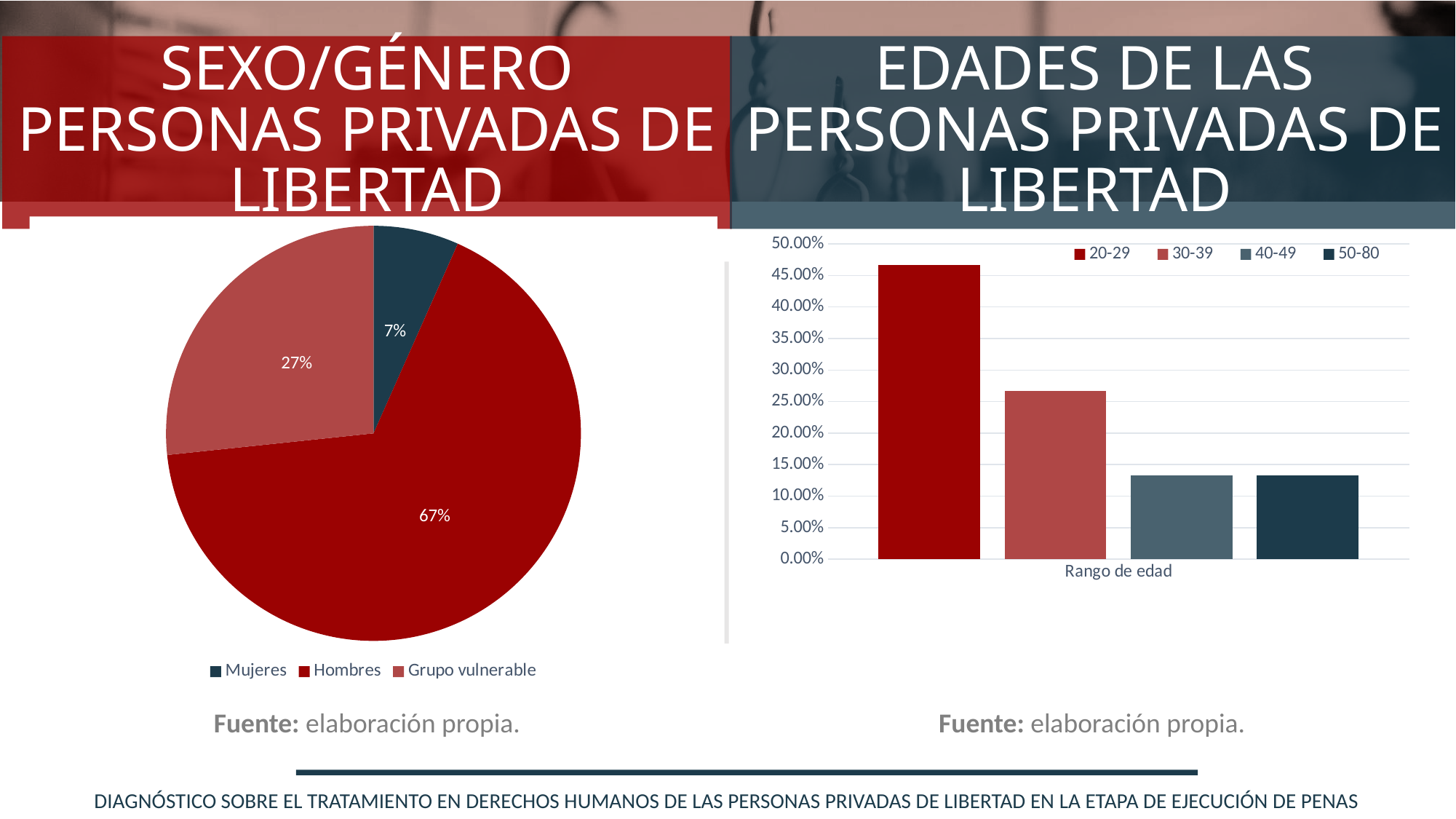
In the pie chart on the left, what percentage is shown for Grupo vulnerable? 27% What kind of chart is the chart on the right (Edades de las personas privadas de libertad)? bar chart In the pie chart on the left, what percentage is shown for Hombres? 67% In the bar chart on the right, is the value for 20-29 greater or less than 45.00%? greater In the pie chart on the left, which category has the smallest slice? Mujeres How many slices does the pie chart on the left have? 3 In the pie chart on the left, what percentage is shown for Mujeres? 7% In the bar chart on the right, which age range has the highest value? 20-29 In the pie chart on the left, what is the difference in percentage points between Hombres and Grupo vulnerable? 40 percentage points In the bar chart on the right, is the value for 40-49 greater or less than 15.00%? less In the pie chart on the left, which category has the largest slice? Hombres How many series does the legend of the chart on the right list? 4